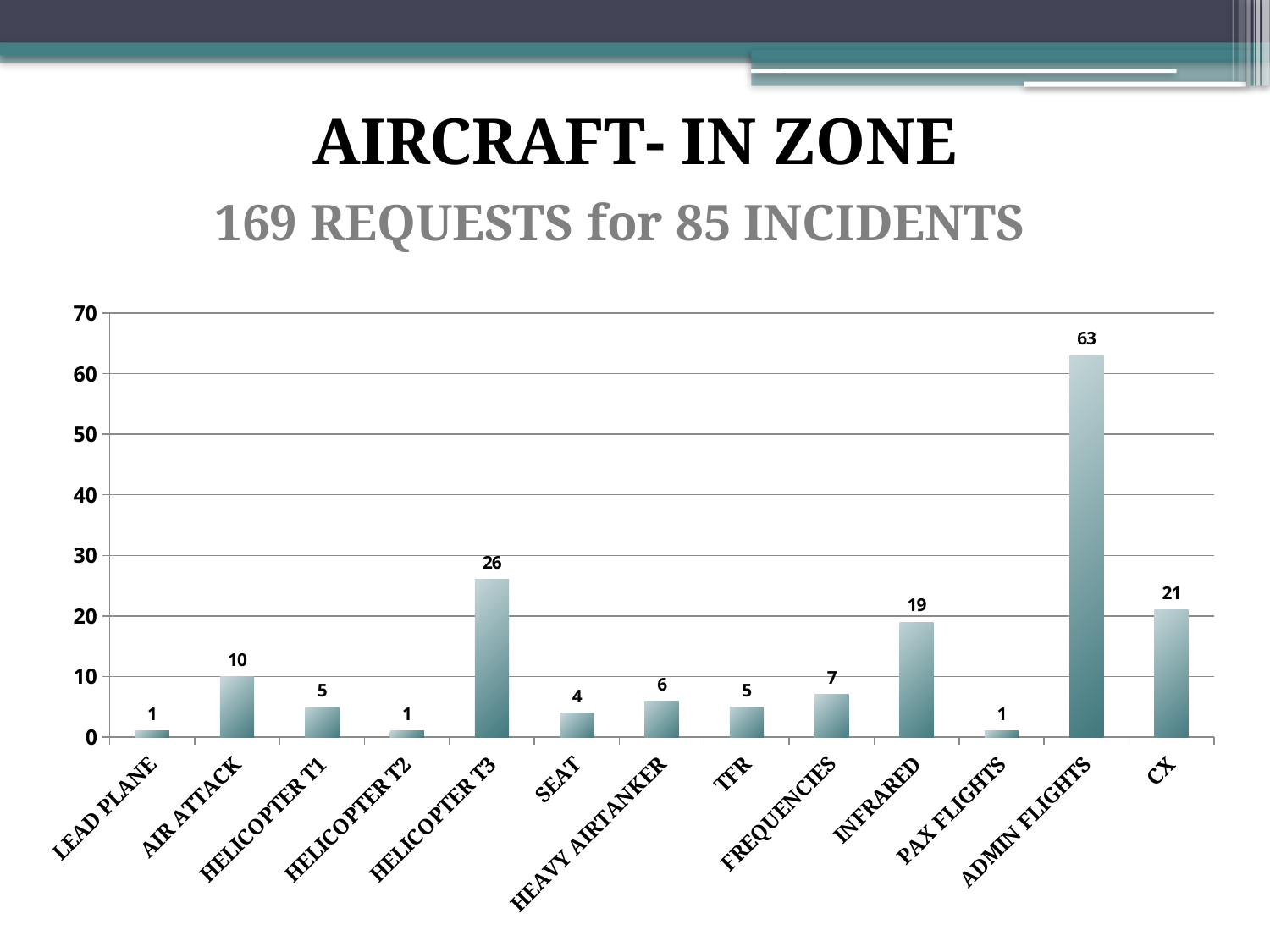
What is the value for HELICOPTER T3? 26 What is the value for FREQUENCIES? 7 Which category has the highest value? ADMIN FLIGHTS What is the value for ADMIN FLIGHTS? 63 What is the difference between the values for ADMIN FLIGHTS and HELICOPTER T3? 37 What kind of chart is shown on the slide? Bar chart How many categories are shown on the x axis? 13 What is the difference between the values for CX and INFRARED? 2 What is the value for INFRARED? 19 What is the value for CX? 21 What is the title of the slide? AIRCRAFT- IN ZONE Which is larger, the value for AIR ATTACK or the value for HEAVY AIRTANKER? AIR ATTACK